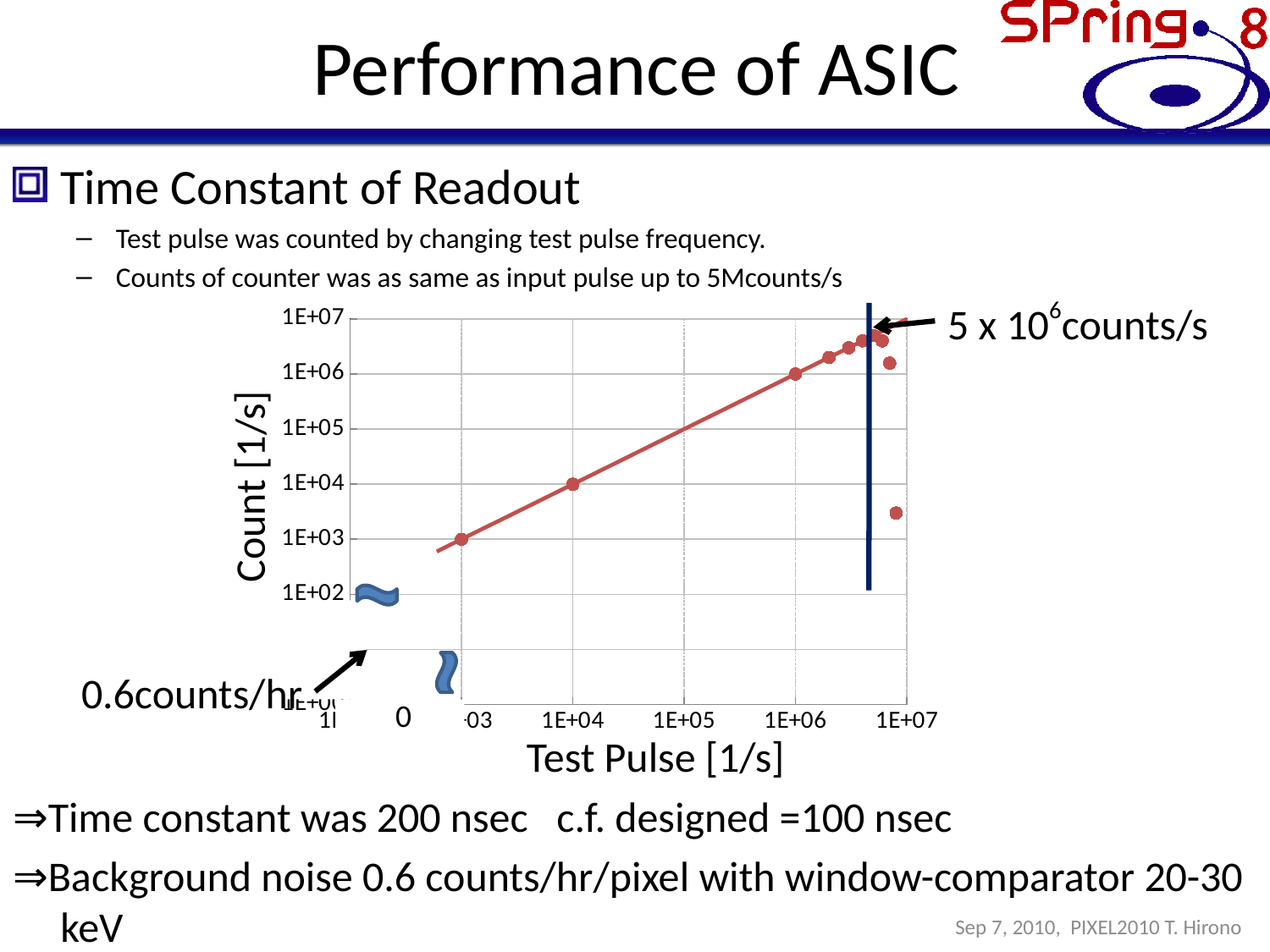
What is the count value at a test pulse frequency of 1E+04 1/s? 1E+04 What is the count value at a test pulse frequency of 1E+06 1/s? 1E+06 Is the count for the data point at about 2E+06 test pulse greater or less than 1E+06? greater What kind of chart is shown on the slide? scatter chart Is the count for the rightmost data point (near 1E+07 test pulse) greater or less than 1E+04? less Do the plotted counts rise or fall as the test pulse frequency increases from 1E+03 to 1E+06? rise Is the count at 1E+03 test pulse greater or less than 1E+04? less What is the highest tick value shown on the y axis of the chart? 1E+07 What is the count value at a test pulse frequency of 1E+03 1/s? 1E+03 What is the title of the y axis of the chart? Count [1/s] What is the title of the x axis of the chart? Test Pulse [1/s] Which has the higher count: the point at 1E+04 test pulse or the point at 1E+06 test pulse? the point at 1E+06